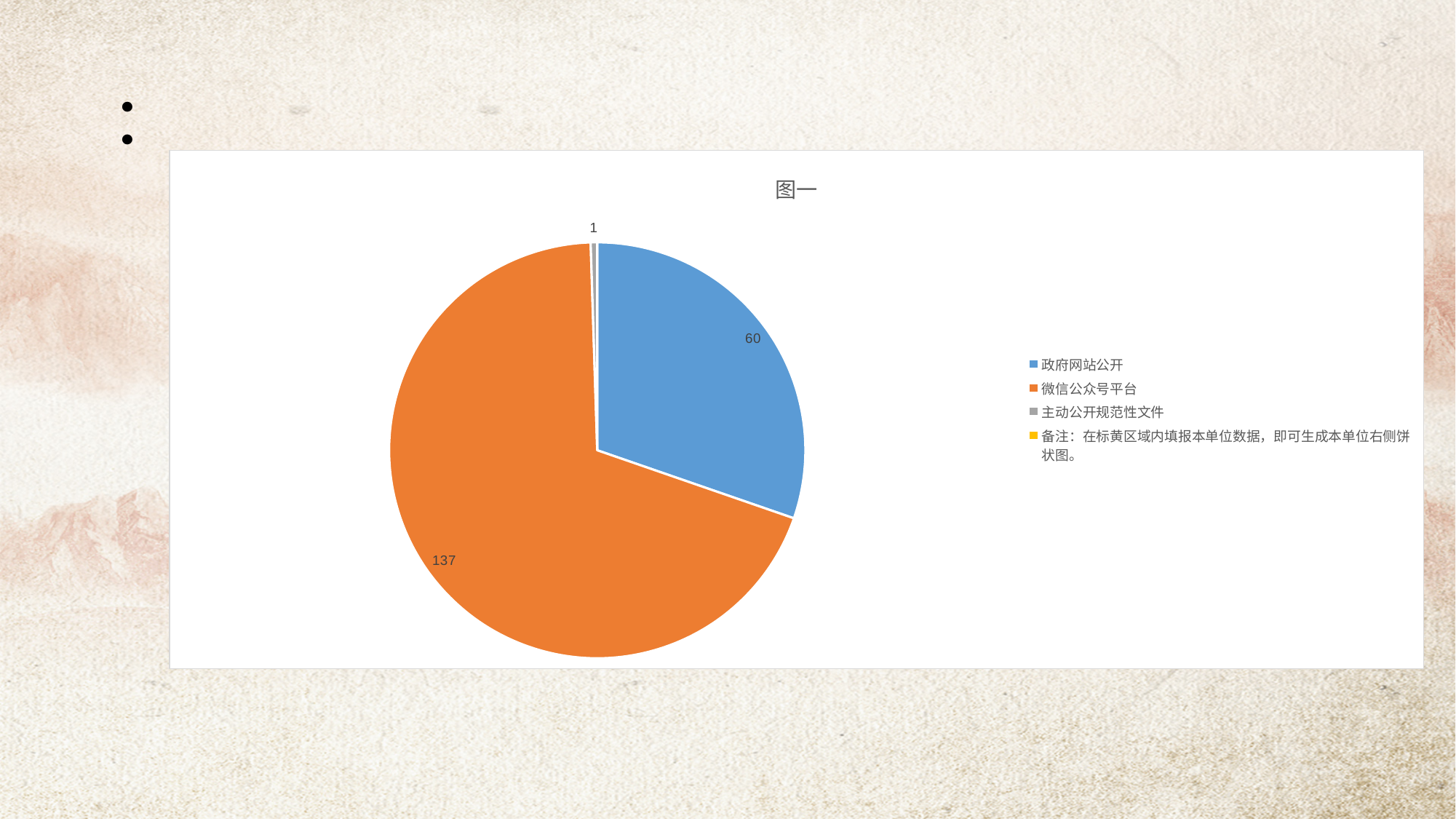
What is the difference between the values for 政府网站公开 and 主动公开规范性文件? 59 Which category has the largest slice? 微信公众号平台 Which category has the smallest slice? 主动公开规范性文件 What is the title of the chart? 图一 What is the difference between the values for 微信公众号平台 and 政府网站公开? 77 What is the value for 主动公开规范性文件? 1 What is the value for 微信公众号平台? 137 How many entries does the legend list? 4 What type of chart is shown on the slide? pie chart What is the value for 政府网站公开? 60 What colour is the slice for 政府网站公开? blue Which is larger, the value for 政府网站公开 or the value for 微信公众号平台? 微信公众号平台